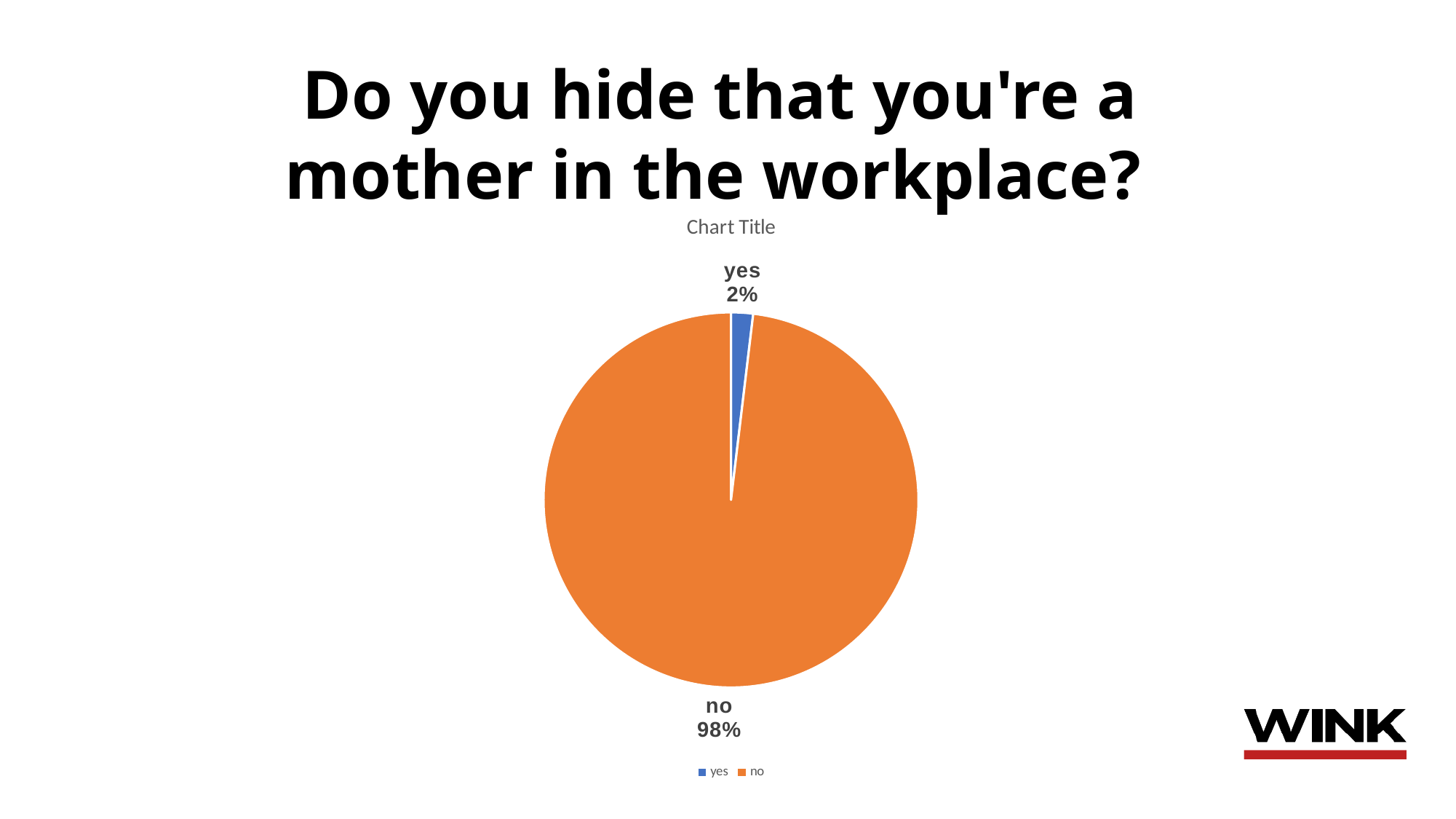
What colour is the "yes" slice? blue Which is larger, the share for "yes" or the share for "no"? no What share of the pie does the "no" slice represent? 98% What is the difference in percentage points between the "no" and "yes" shares? 96 What type of chart is shown on the slide? pie chart What percentage of respondents answered "no"? 98% How many slices does the pie chart have? 2 Which response has the smallest share of the pie? yes What is the title text shown directly above the pie chart? Chart Title What percentage of respondents answered "yes"? 2% How many entries does the legend list? 2 Which response has the largest share of the pie? no